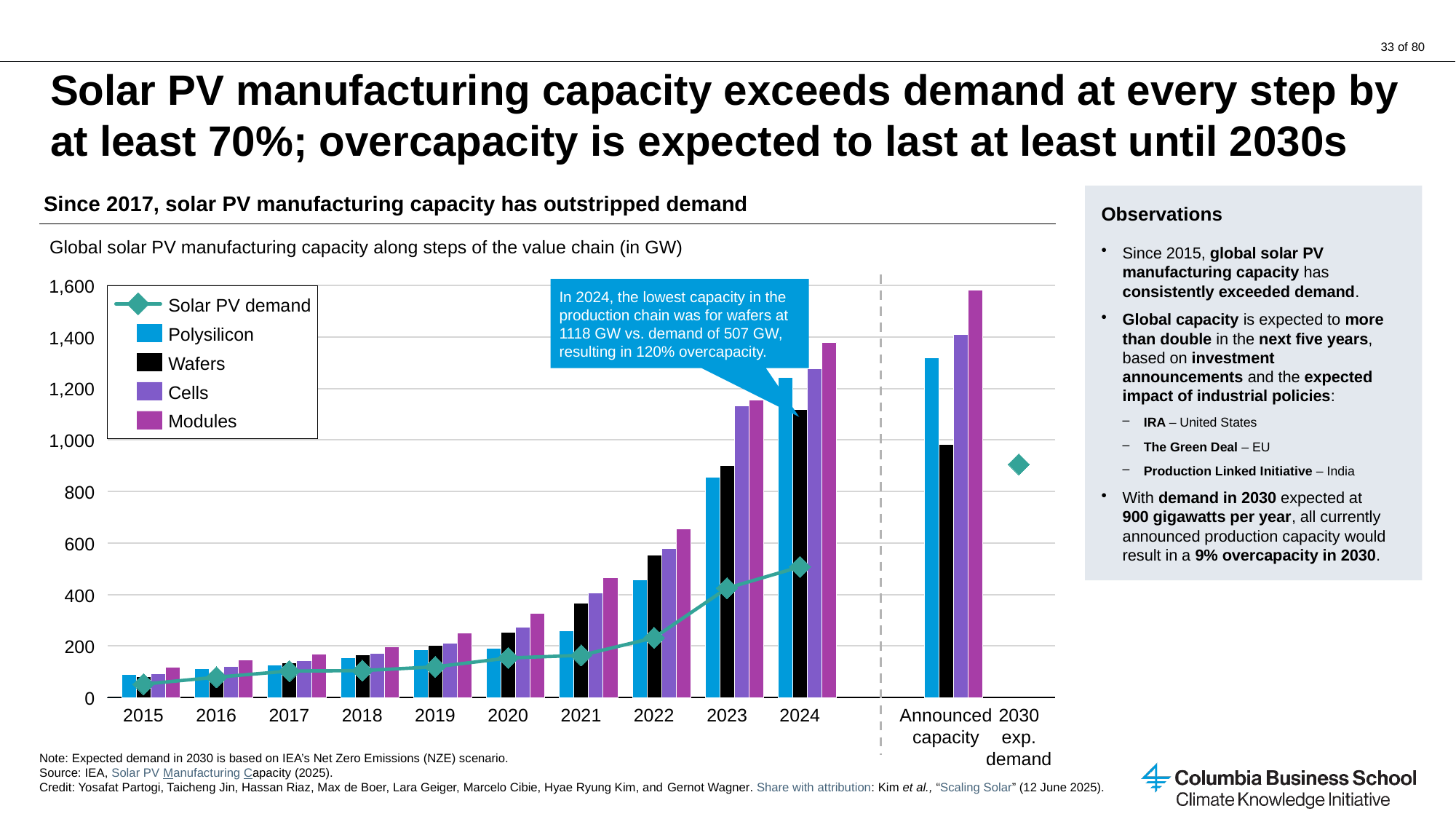
According to the callout on the chart, what was the wafer manufacturing capacity in 2024? 1118 GW Which value-chain step had the highest manufacturing capacity in 2024? Modules What kind of chart is shown on the slide? Bar chart with a line series Is the Polysilicon value for Announced capacity greater or less than 1,200? greater Is the Modules value for 2024 greater or less than 1,200? greater Does the Solar PV demand line rise or fall from 2015 to 2024? Rises Using the values in the callout, how much did 2024 wafer capacity exceed 2024 solar PV demand? 611 GW According to the callout on the chart, what was solar PV demand in 2024? 507 GW How many series does the chart legend list? 5 Among the years 2015 to 2024, which year has the lowest Modules bar? 2015 In 2024, which is larger: Polysilicon capacity or Wafers capacity? Polysilicon How many years from 2015 onward are shown as bar groups before the dashed divider? 10